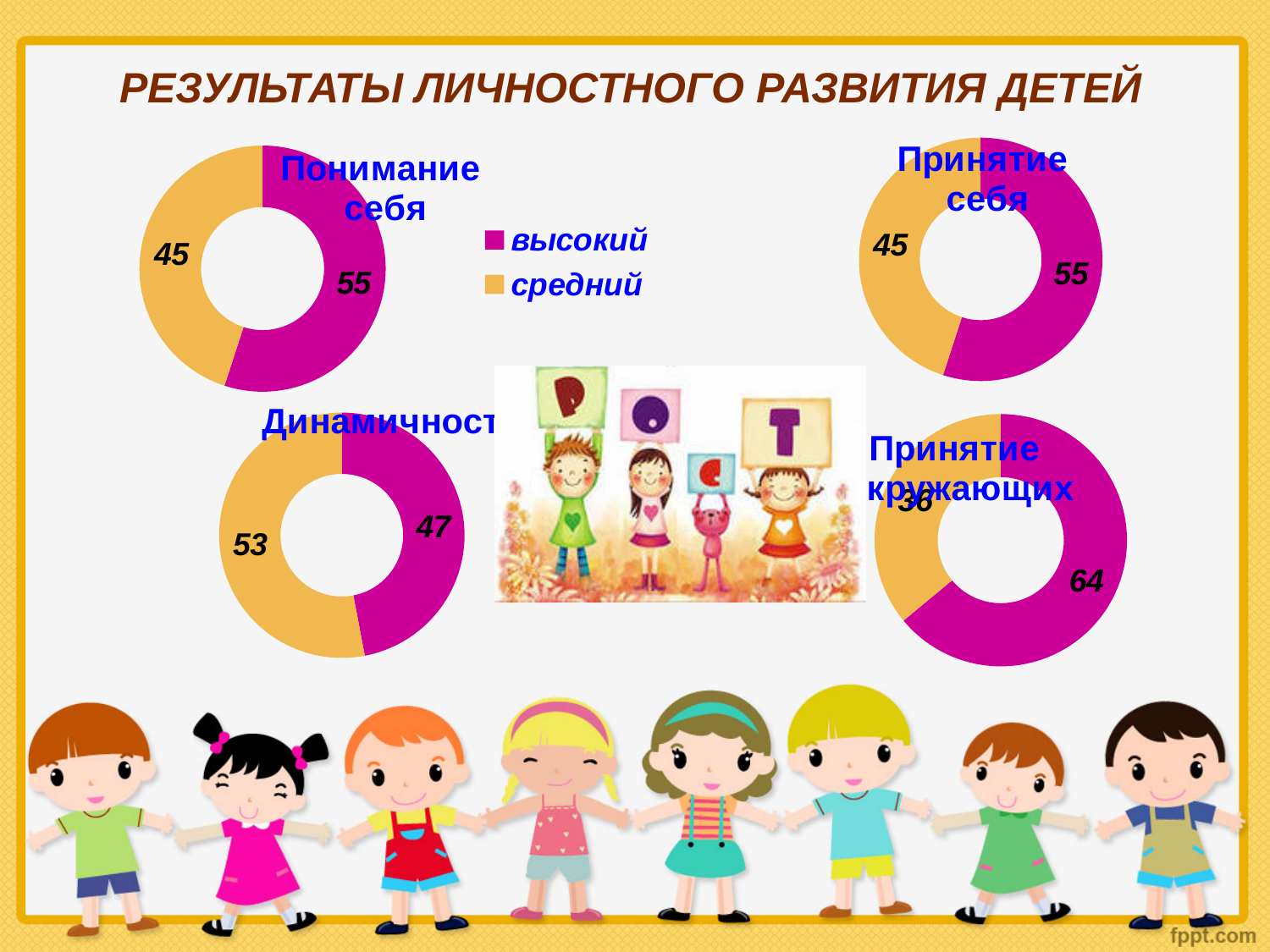
How many categories does the 'Динамичность' chart show? 2 In the 'Динамичность' chart, what is the value for 'высокий'? 47 In the 'Динамичность' chart, which category has the larger value, 'высокий' or 'средний'? средний In the 'Принятие окружающих' chart, which category has the largest value? высокий In the 'Динамичность' chart, what is the value for 'средний'? 53 What type of chart is the 'Принятие себя' chart? doughnut chart In the 'Понимание себя' chart, what is the value for 'высокий'? 55 In the 'Понимание себя' chart, what is the difference between the 'высокий' and 'средний' values? 10 Which colour represents 'высокий' in the legend? magenta In the 'Понимание себя' chart, what is the value for 'средний'? 45 In the 'Принятие окружающих' chart, what is the value for 'высокий'? 64 In the 'Принятие себя' chart, what is the value for 'высокий'? 55